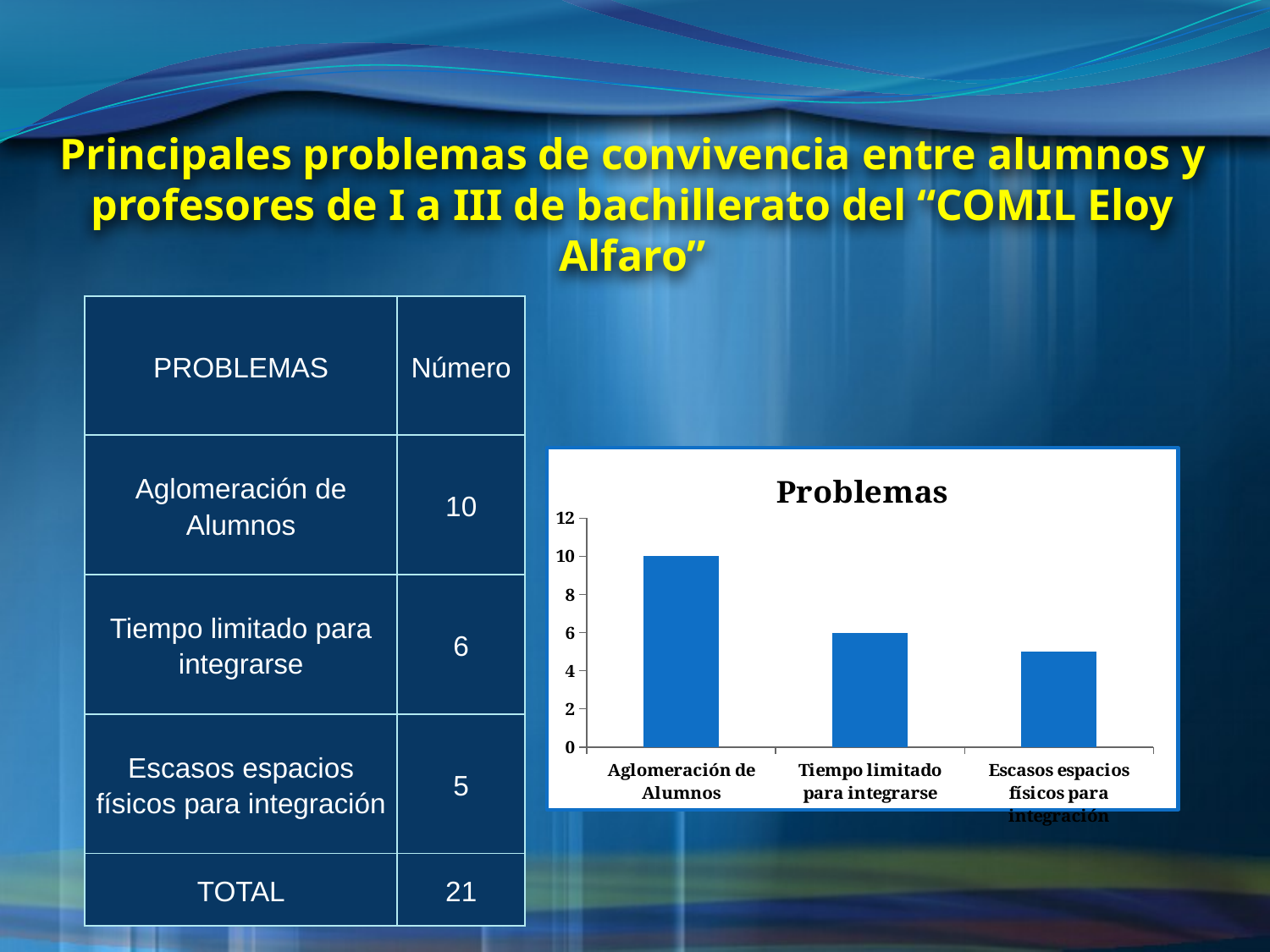
Is the value for Escasos espacios físicos para integración greater or less than 6? less What is the value for Tiempo limitado para integrarse in the chart? 6 What type of chart is shown on the slide? bar chart Which category has the highest value in the chart? Aglomeración de Alumnos Which is larger: the value for Tiempo limitado para integrarse or the value for Escasos espacios físicos para integración? Tiempo limitado para integrarse What is the value for Aglomeración de Alumnos in the chart? 10 What is the title of the chart? Problemas Which category has the lowest value in the chart? Escasos espacios físicos para integración Do the values rise or fall from left to right along the x axis? fall What is the difference between the values for Aglomeración de Alumnos and Tiempo limitado para integrarse? 4 How many categories are plotted in the chart? 3 Is the value for Aglomeración de Alumnos greater or less than 8? greater